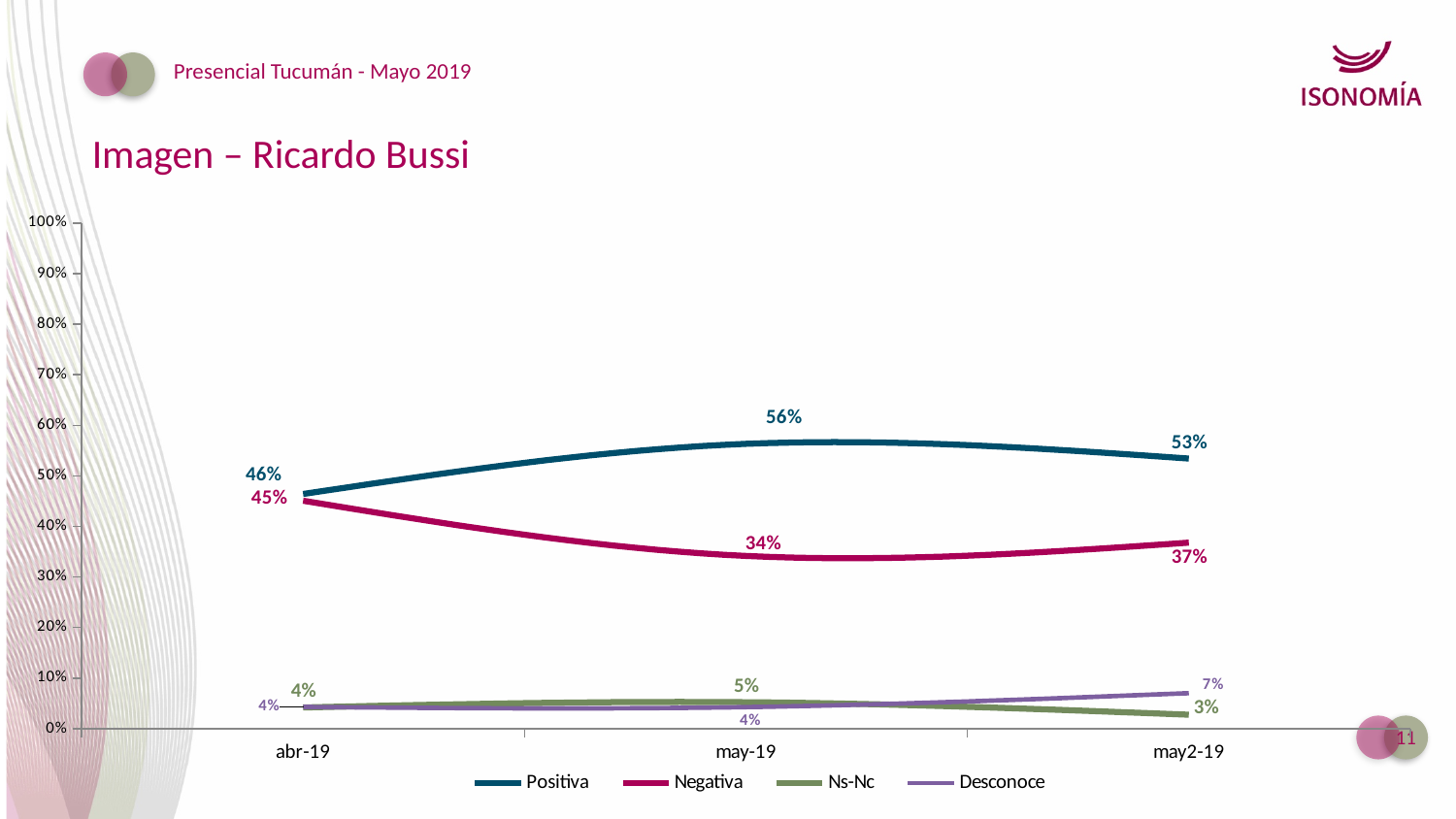
What is the value for Ns-Nc at may-19? 5% What is the value for Positiva at may-19? 56% What kind of chart is shown on the slide? Line chart Does Desconoce rise or fall from may-19 to may2-19? Rise What is the value for Desconoce at may2-19? 7% What is the difference between Positiva and Negativa at may-19? 22% What is the value for Negativa at may2-19? 37% At which point along the x axis is Negativa lowest? may-19 At which point along the x axis is Positiva highest? may-19 Which is larger at abr-19, Positiva or Negativa? Positiva How many series does the legend list? 4 How many points along the x axis does the chart show? 3